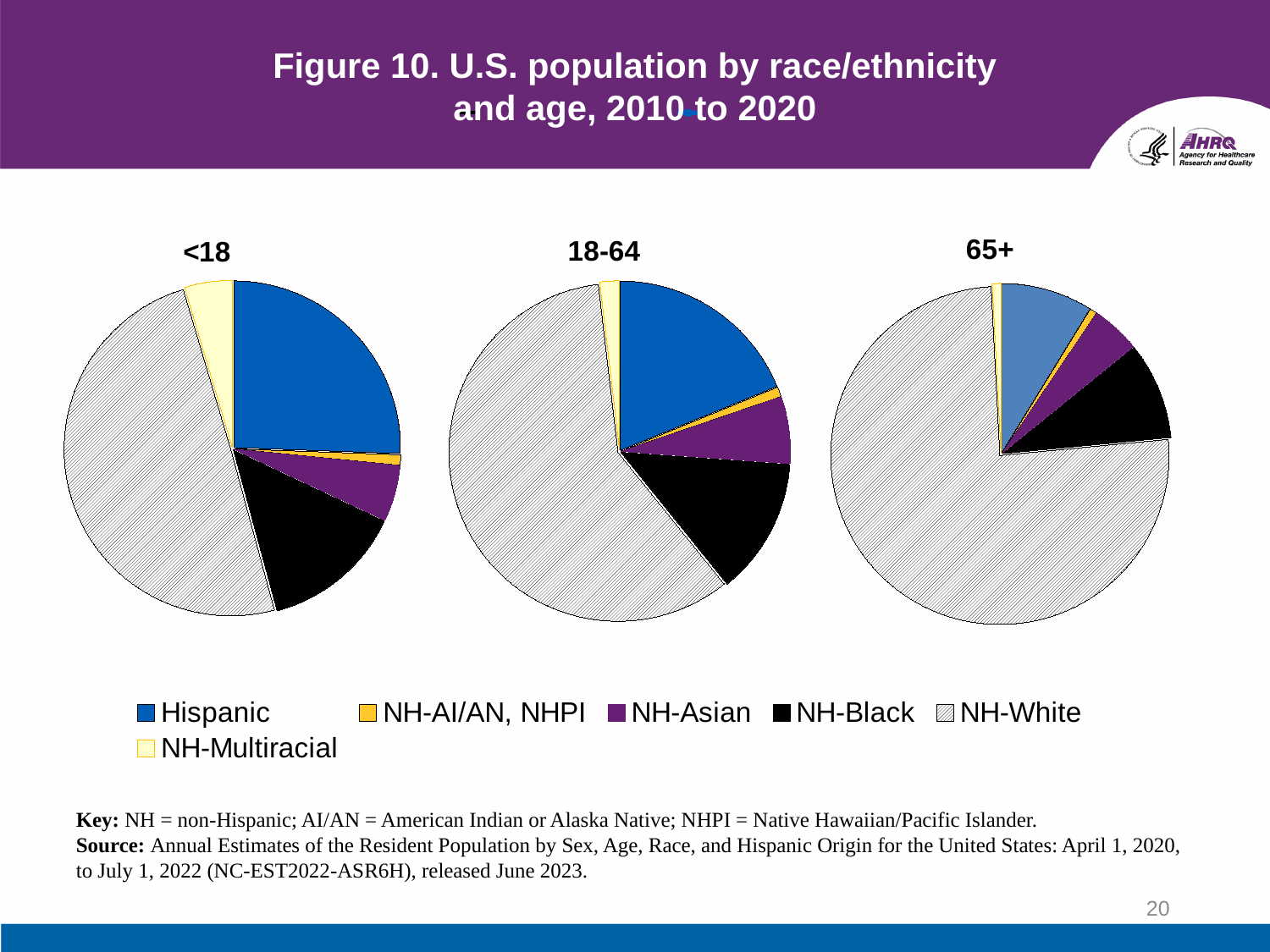
How many pie charts are on the slide? 3 What is the figure number and title of the slide? Figure 10. U.S. population by race/ethnicity and age, 2010 to 2020 In the <18 pie chart, which race/ethnicity group has the smallest share? NH-AI/AN, NHPI In the 18-64 pie chart, which race/ethnicity group has the largest share? NH-White What are the three age groups shown as pie chart titles? <18, 18-64, 65+ How many race/ethnicity groups does the legend list? 6 What kind of charts are shown on the slide? Pie charts In the 65+ pie chart, which is larger, the Hispanic slice or the NH-Asian slice? Hispanic In the <18 pie chart, which is larger, the Hispanic slice or the NH-Black slice? Hispanic In the 18-64 pie chart, which is larger, the NH-Black slice or the NH-Asian slice? NH-Black In the 65+ pie chart, which race/ethnicity group has the largest share? NH-White In the <18 pie chart, which race/ethnicity group has the largest share? NH-White